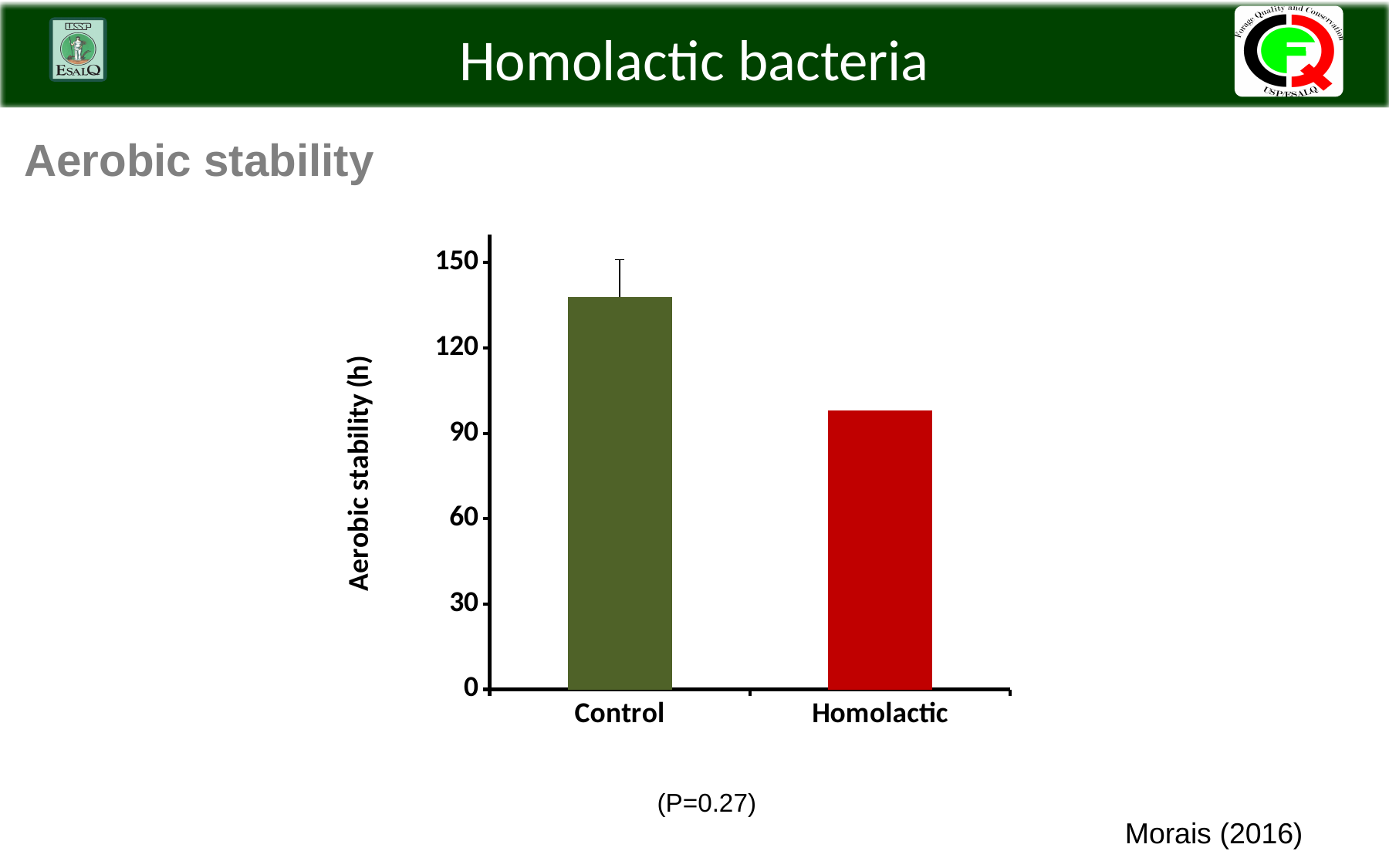
Is the value for Homolactic greater or less than 90? greater Is the value for Control greater or less than 120? greater Which category has the lowest aerobic stability? Homolactic Is the value for Homolactic greater or less than 120? less What kind of chart is shown on the slide? bar chart What is the label of the y axis of the chart? Aerobic stability (h) Which has a larger aerobic stability value, Control or Homolactic? Control Which category has the highest aerobic stability? Control How many categories are plotted on the x axis of the chart? 2 What P value is printed below the chart? P=0.27